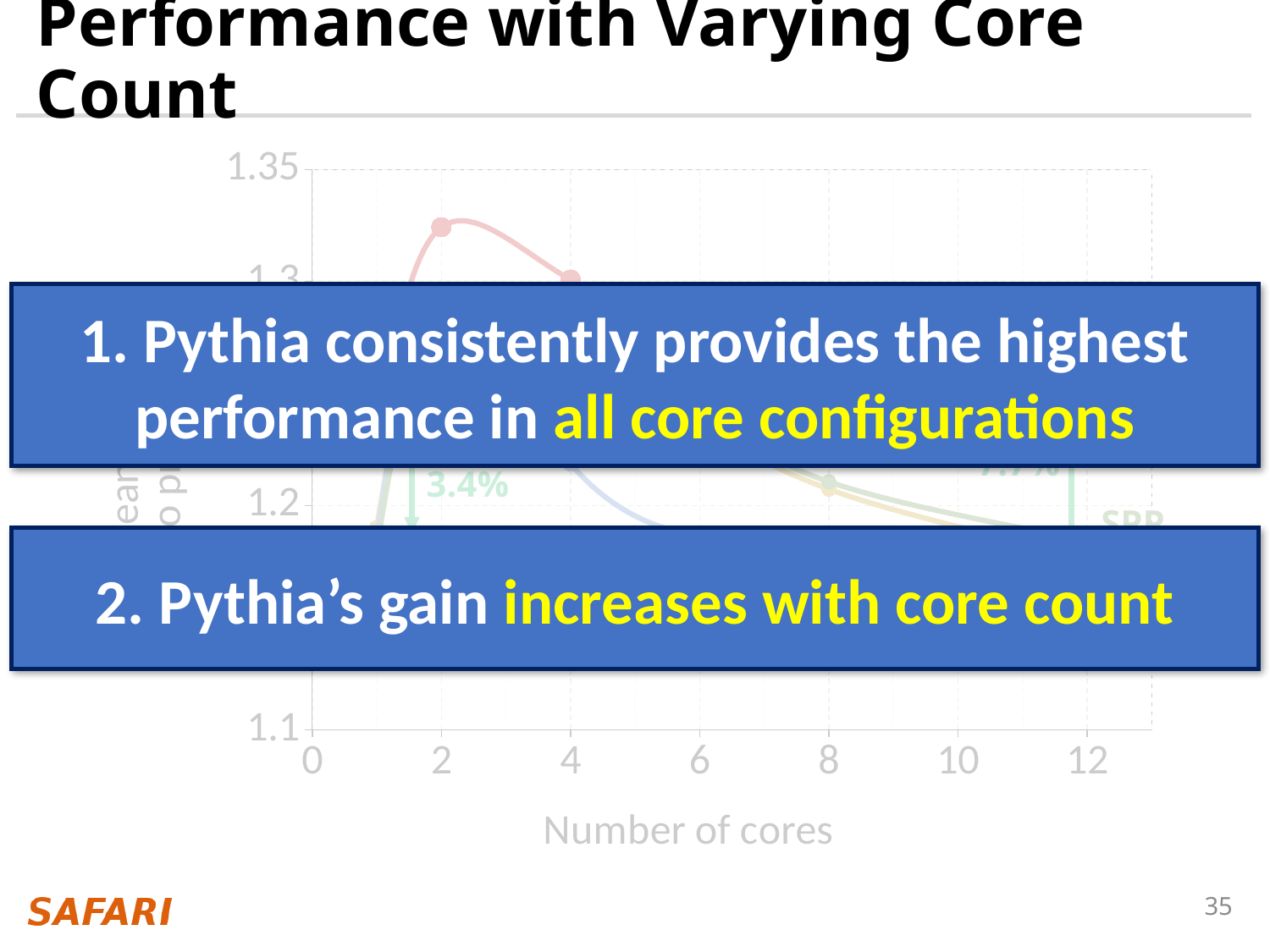
What kind of chart is shown on the slide? line chart What is the largest tick value shown on the x axis of the chart? 12 Is the value of the red line at 2 cores greater or less than 1.3? greater Does the red line rise or fall between 2 cores and 4 cores? fall What is the title of the x axis of the chart? Number of cores What is the highest tick value shown on the y axis of the chart? 1.35